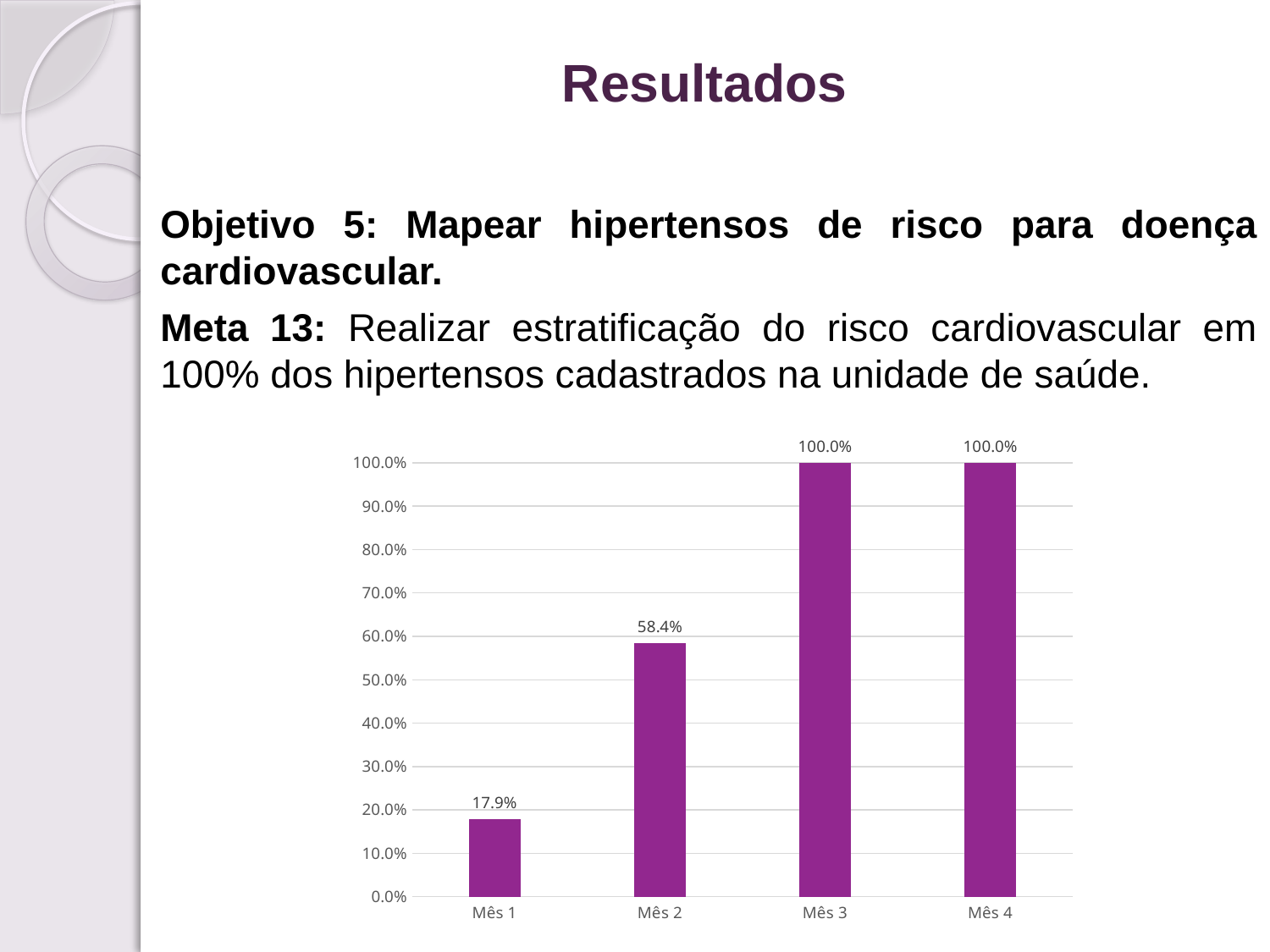
Do the values rise or fall from Mês 1 to Mês 3? rise Is the value for Mês 1 greater or less than 20.0%? less What is the difference between the values for Mês 2 and Mês 1? 40.5% What is the difference between the values for Mês 3 and Mês 2? 41.6% What is the value for Mês 3? 100.0% What is the value for Mês 2? 58.4% What is the value for Mês 1? 17.9% Which month has the lowest value? Mês 1 Is the value for Mês 2 greater or less than 50.0%? greater How many months are shown on the x axis? 4 What kind of chart is shown on the slide? bar chart Which is larger, the value for Mês 1 or the value for Mês 2? Mês 2